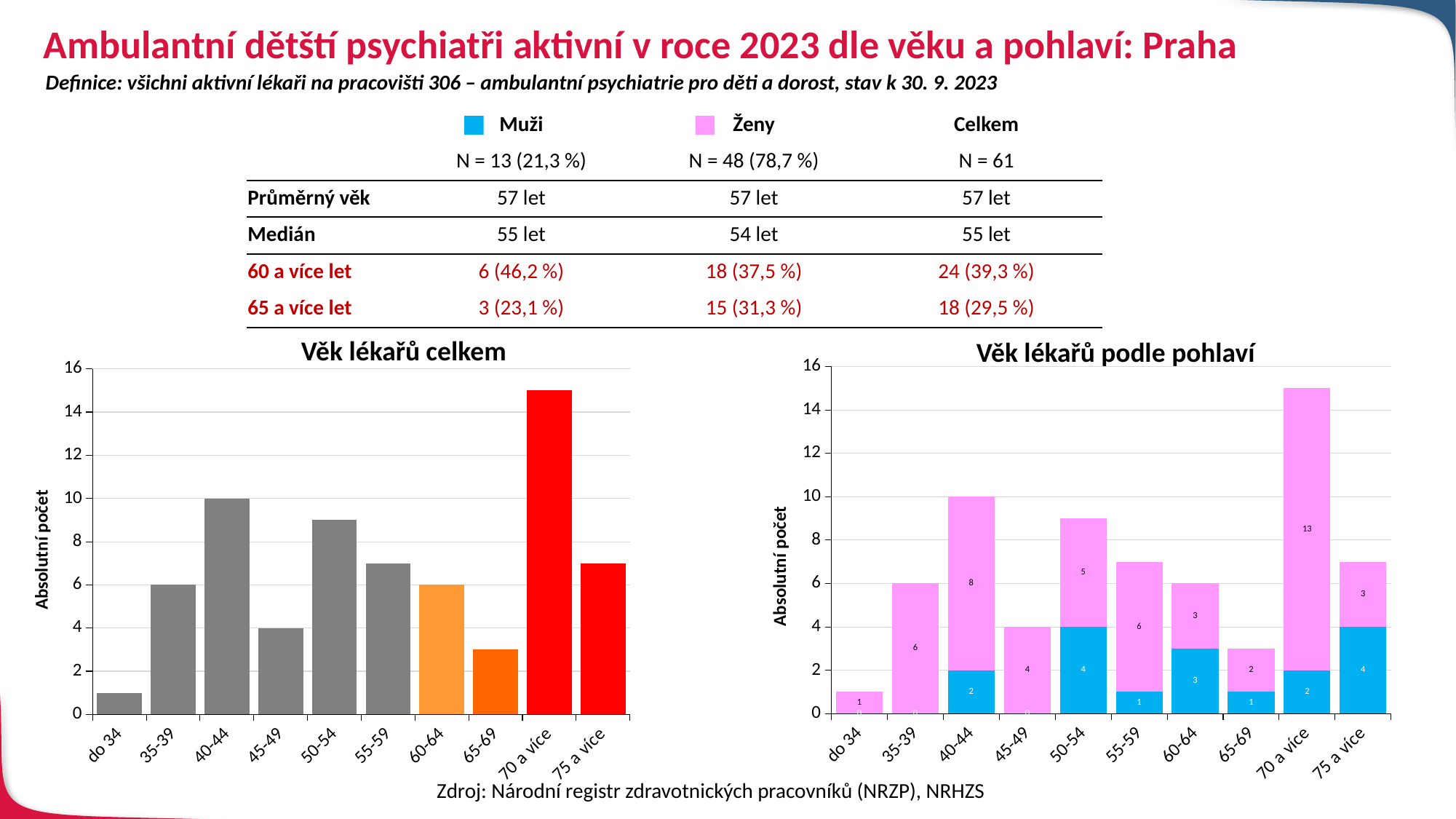
In the chart titled 'Věk lékařů celkem', how many age categories are shown on the x axis? 10 In the chart titled 'Věk lékařů podle pohlaví', what is the difference between Ženy and Muži in the 40-44 category? 6 In the chart titled 'Věk lékařů podle pohlaví', what is the value for Ženy in the 70 a více category? 13 In the chart titled 'Věk lékařů celkem', what is the value for the 40-44 category? 10 In the chart titled 'Věk lékařů celkem', which age category has the highest value? 70 a více In the chart titled 'Věk lékařů celkem', is the value for 50-54 greater or less than 8? greater In the chart titled 'Věk lékařů podle pohlaví', what is the total of the stacked bar for 70 a více? 15 In the chart titled 'Věk lékařů podle pohlaví', which is larger in the 75 a více category, Muži or Ženy? Muži In the chart titled 'Věk lékařů podle pohlaví', what is the value for Muži in the 50-54 category? 4 In the chart titled 'Věk lékařů celkem', which age category has the lowest value? do 34 In the chart titled 'Věk lékařů celkem', what kind of chart is shown? bar chart